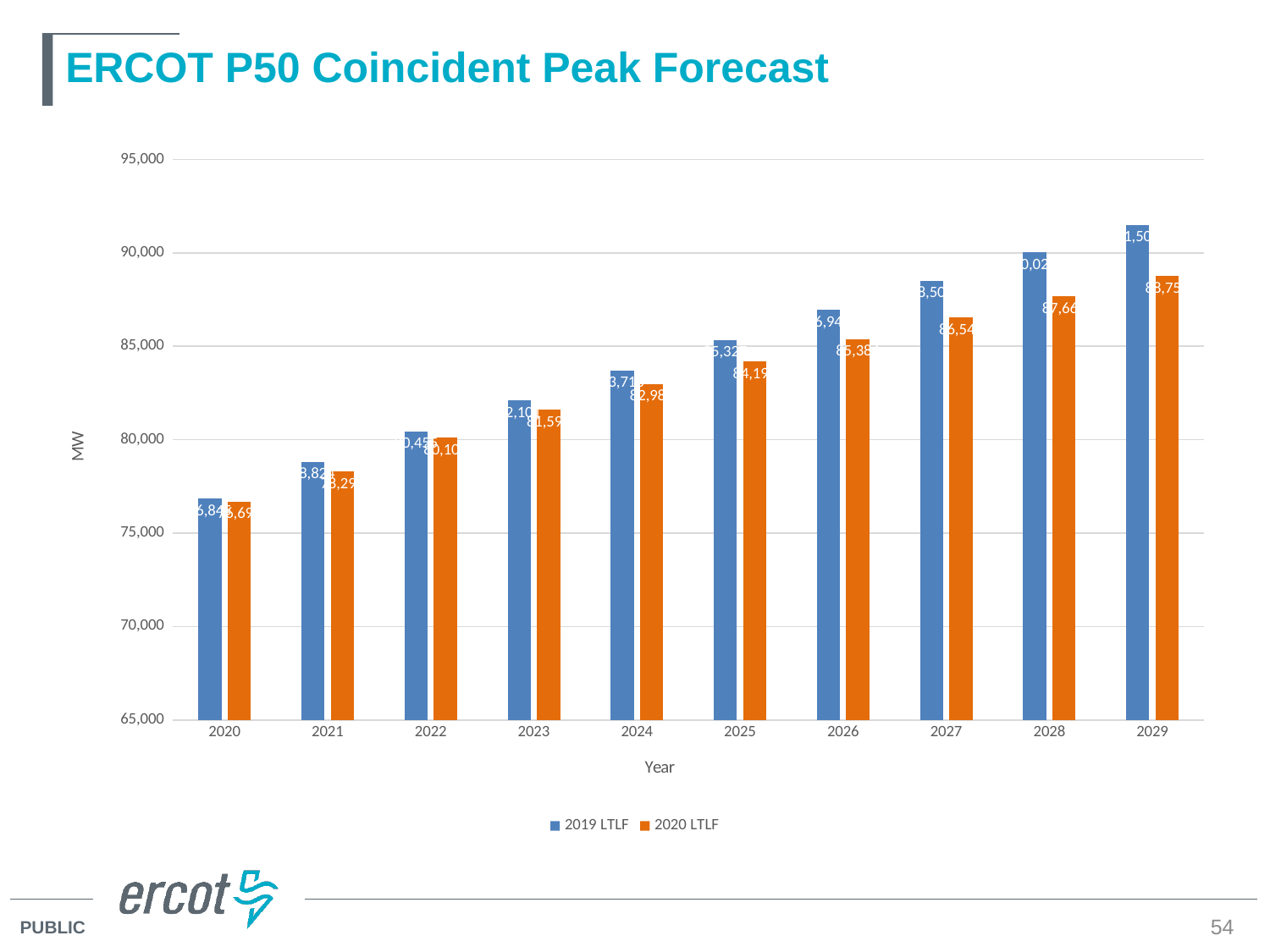
How many years are shown on the x axis? 10 How many series does the legend list? 2 Is the 2019 LTLF value for 2029 greater or less than 90,000? greater What is the label on the y axis? MW Which year has the highest 2019 LTLF value? 2029 Is the 2020 LTLF value for 2029 greater or less than 90,000? less Do the 2020 LTLF values rise or fall from 2020 to 2029? rise Which year has the lowest 2020 LTLF value? 2020 For 2027, which series has the larger value, 2019 LTLF or 2020 LTLF? 2019 LTLF Is the 2019 LTLF value for 2021 greater or less than 80,000? less What kind of chart is shown on the slide? bar chart